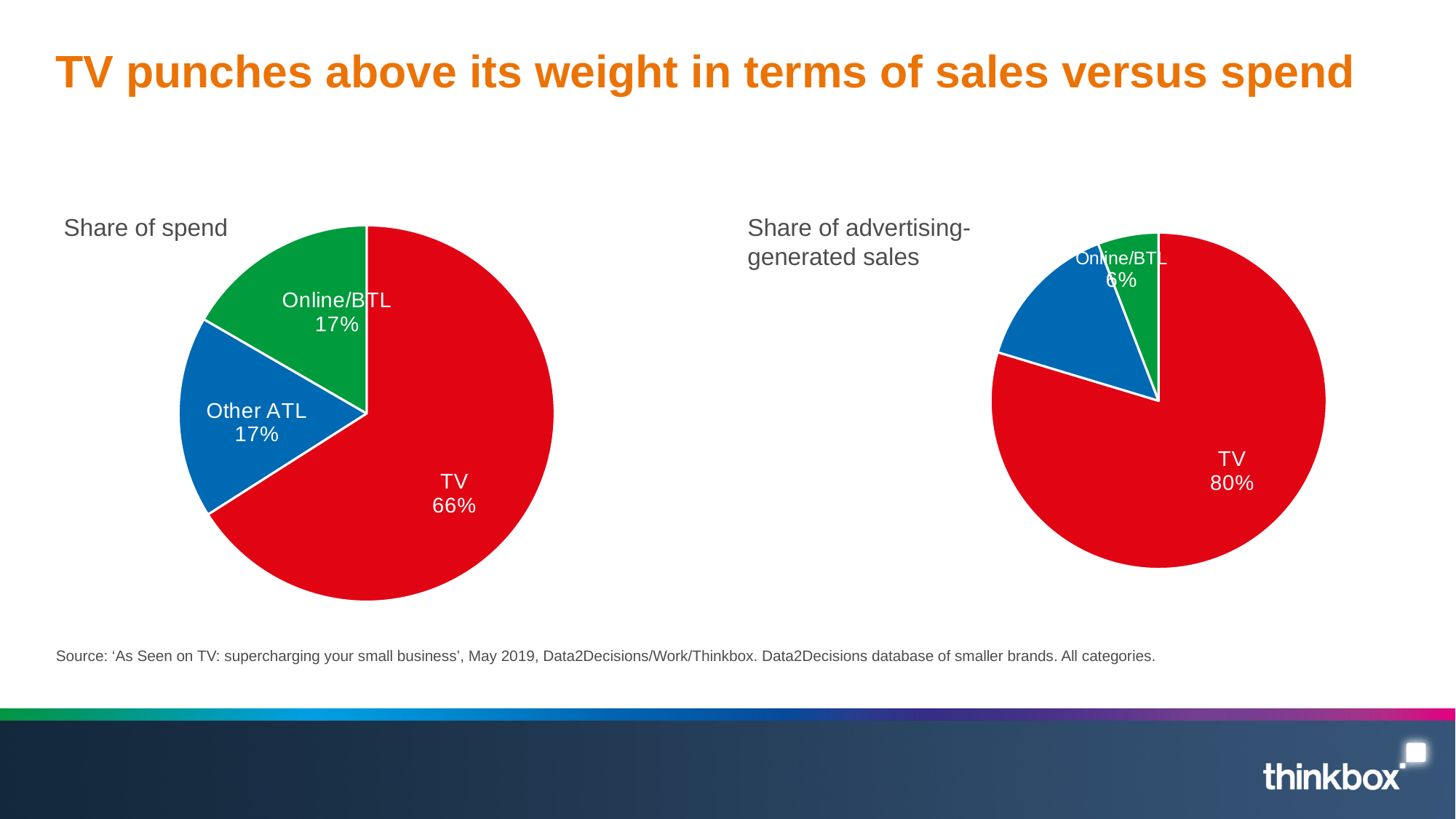
In the 'Share of spend' pie chart, what is the share for TV? 66% What type of chart is used for 'Share of spend'? Pie chart In the 'Share of spend' pie chart, what is the difference in percentage points between TV and Other ATL? 49 percentage points In the 'Share of advertising-generated sales' pie chart, which category has the smallest slice? Online/BTL In the 'Share of advertising-generated sales' pie chart, what is the share for Online/BTL? 6% In the 'Share of advertising-generated sales' pie chart, what is the share for TV? 80% In the 'Share of advertising-generated sales' pie chart, which is larger: the TV slice or the Online/BTL slice? TV How many percentage points higher is TV's share in the 'Share of advertising-generated sales' chart than in the 'Share of spend' chart? 14 percentage points How many slices does the 'Share of spend' pie chart have? 3 In the 'Share of spend' pie chart, what is the share for Other ATL? 17% What colour is the TV slice in both pie charts? Red In the 'Share of spend' pie chart, which category has the largest slice? TV